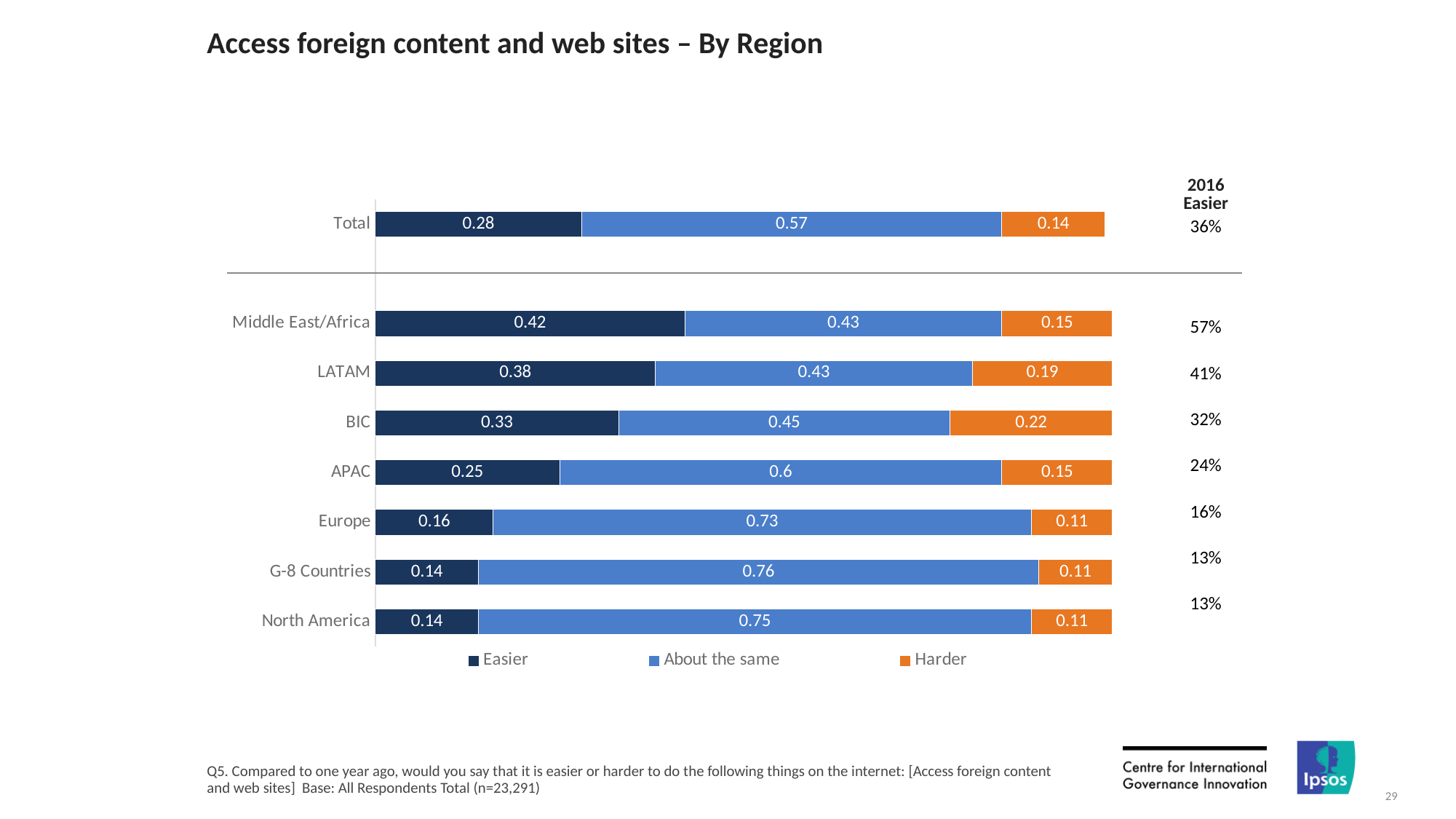
Which region has the highest 'Easier' value? Middle East/Africa How many regions (including Total) are shown on the chart? 8 What is the difference between the 'Easier' values for LATAM and APAC? 0.13 What is the 'Easier' value for Middle East/Africa? 0.42 What is the 2016 Easier percentage shown for APAC? 24% Which is larger, the 'Harder' value for LATAM or the 'Harder' value for Europe? LATAM What kind of chart is shown on the slide? Stacked bar chart What is the 'Harder' value for BIC? 0.22 How many series does the legend list? 3 What is the 'About the same' value for G-8 Countries? 0.76 What is the total of the stacked bar for Total (Easier + About the same + Harder)? 0.99